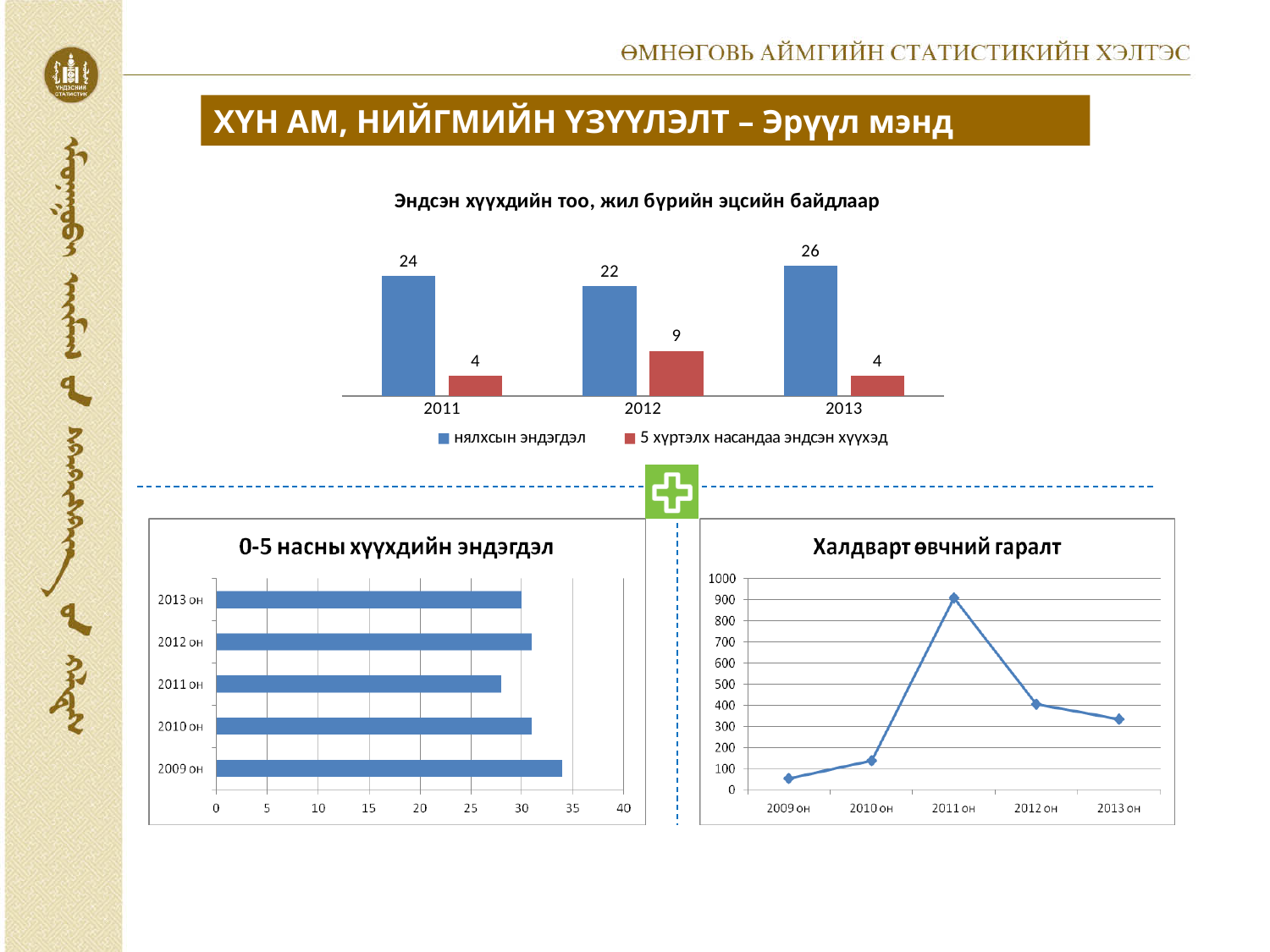
How many series does the legend of the chart 'Эндсэн хүүхдийн тоо, жил бүрийн эцсийн байдлаар' list? 2 In the chart 'Эндсэн хүүхдийн тоо, жил бүрийн эцсийн байдлаар', what is the difference between нялхсын эндэгдэл and 5 хүртэлх насандаа эндсэн хүүхэд in 2011? 20 What kind of chart is '0-5 насны хүүхдийн эндэгдэл'? Bar chart In the chart 'Эндсэн хүүхдийн тоо, жил бүрийн эцсийн байдлаар', what is the value for нялхсын эндэгдэл in 2013? 26 In the chart '0-5 насны хүүхдийн эндэгдэл', is the value for 2011 он greater or less than 30? less In the chart '0-5 насны хүүхдийн эндэгдэл', which year has the highest value? 2009 он How many years are shown in the chart 'Халдварт өвчний гаралт'? 5 In the chart 'Халдварт өвчний гаралт', which year has the highest value? 2011 он In the chart 'Эндсэн хүүхдийн тоо, жил бүрийн эцсийн байдлаар', which colour represents нялхсын эндэгдэл? Blue In the chart 'Халдварт өвчний гаралт', is the value for 2012 он greater or less than 500? less In the chart 'Эндсэн хүүхдийн тоо, жил бүрийн эцсийн байдлаар', which year has the highest value for нялхсын эндэгдэл? 2013 In the chart 'Эндсэн хүүхдийн тоо, жил бүрийн эцсийн байдлаар', what is the value for 5 хүртэлх насандаа эндсэн хүүхэд in 2012? 9